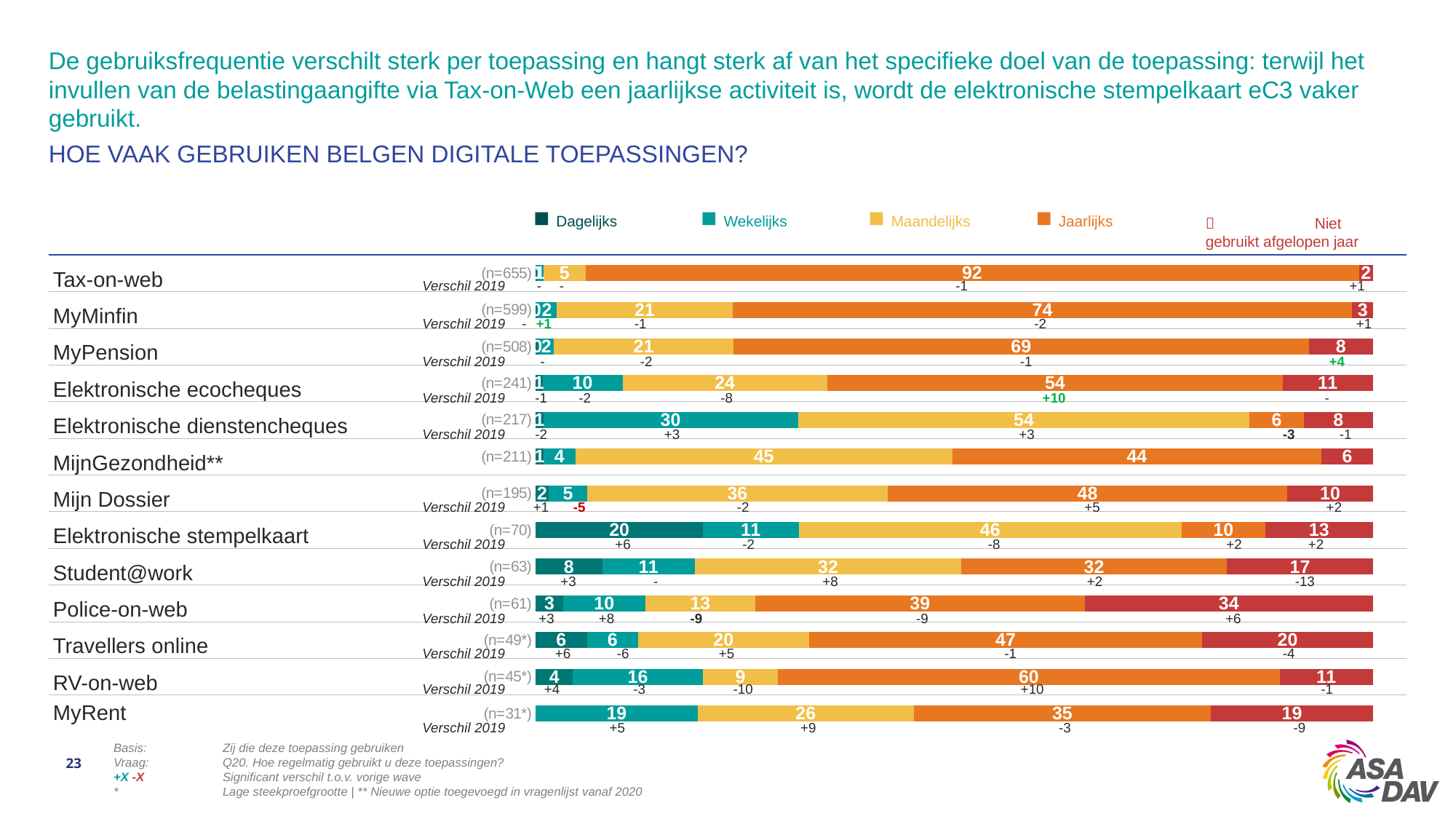
How many digital applications (categories) are plotted in the chart? 13 How many series does the legend list? 5 Which application has the highest Dagelijks value? Elektronische stempelkaart What is the 'Niet gebruikt afgelopen jaar' value for Police-on-web? 34 What is the difference between the Jaarlijks values of MyMinfin and MyPension? 5 Which is larger: the Wekelijks value for Elektronische dienstencheques or the Wekelijks value for MyRent? Elektronische dienstencheques What is the Dagelijks value for Elektronische stempelkaart? 20 What kind of chart is shown on the slide? Stacked bar chart What is the Maandelijks value for Elektronische dienstencheques? 54 What is the Jaarlijks value for Tax-on-web? 92 Which application has the highest Jaarlijks value? Tax-on-web What is the sample size (n) shown for Tax-on-web? n=655